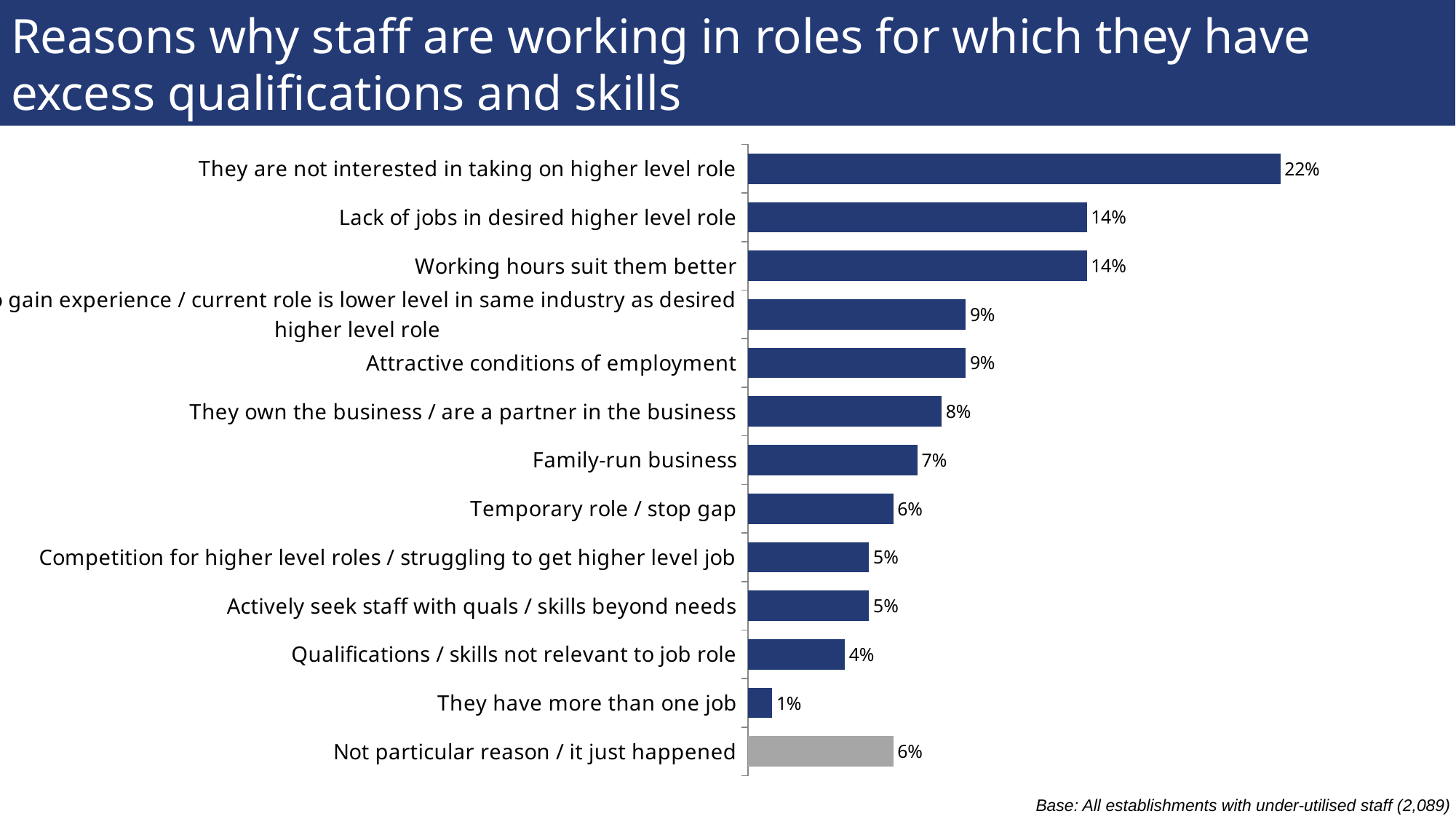
Which is larger: 'They own the business / are a partner in the business' or 'Temporary role / stop gap'? They own the business / are a partner in the business What is the value for 'Family-run business'? 7% What is the difference between 'They are not interested in taking on higher level role' and 'Lack of jobs in desired higher level role'? 8% Which reason has the lowest percentage? They have more than one job Which reason has the highest percentage? They are not interested in taking on higher level role What kind of chart is shown on the slide? bar chart How many reasons (bars) are shown in the chart? 13 What is the value for 'Not particular reason / it just happened'? 6% What percentage is shown for 'They are not interested in taking on higher level role'? 22% What is the value for 'Working hours suit them better'? 14% Which bar is shown in grey rather than dark blue? Not particular reason / it just happened What percentage is shown for 'They have more than one job'? 1%